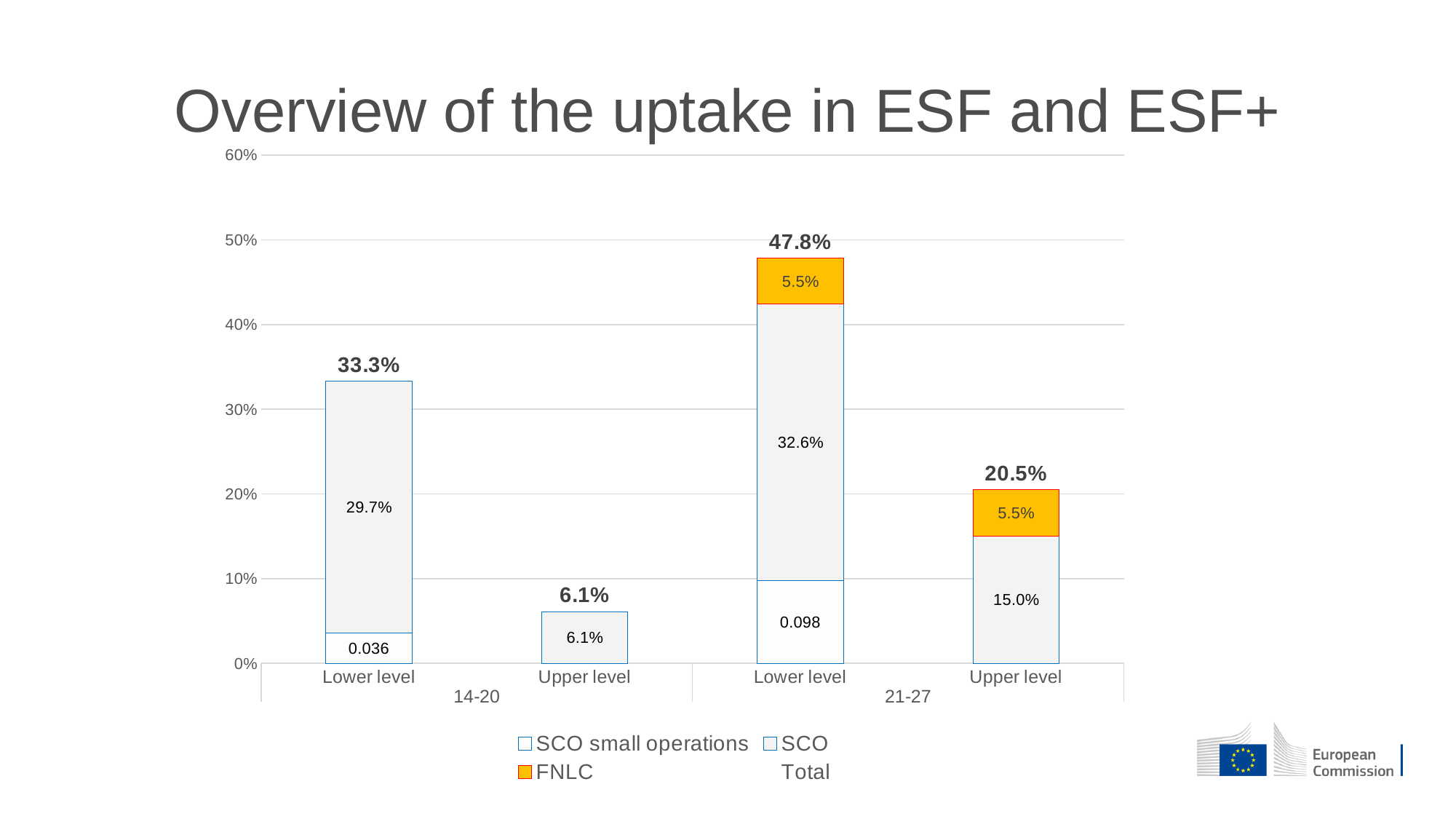
Which bar has the highest total? Lower level, 21-27 Which bar has the lowest total? Upper level, 14-20 What is the difference between the totals of the Lower level bars for 21-27 and 14-20? 14.5% How many entries does the legend list? 4 What is the total value shown above the Lower level bar for 21-27? 47.8% What is the FNLC value for the Lower level bar in 21-27? 5.5% Which is larger: the total for Upper level in 21-27 or the total for Upper level in 14-20? Upper level in 21-27 What is the total value shown above the Lower level bar for 14-20? 33.3% What is the SCO value for the Lower level bar in 14-20? 29.7% What type of chart is shown on the slide? Stacked bar chart What is the SCO value for the Upper level bar in 21-27? 15.0% How many bars are plotted in the chart? 4